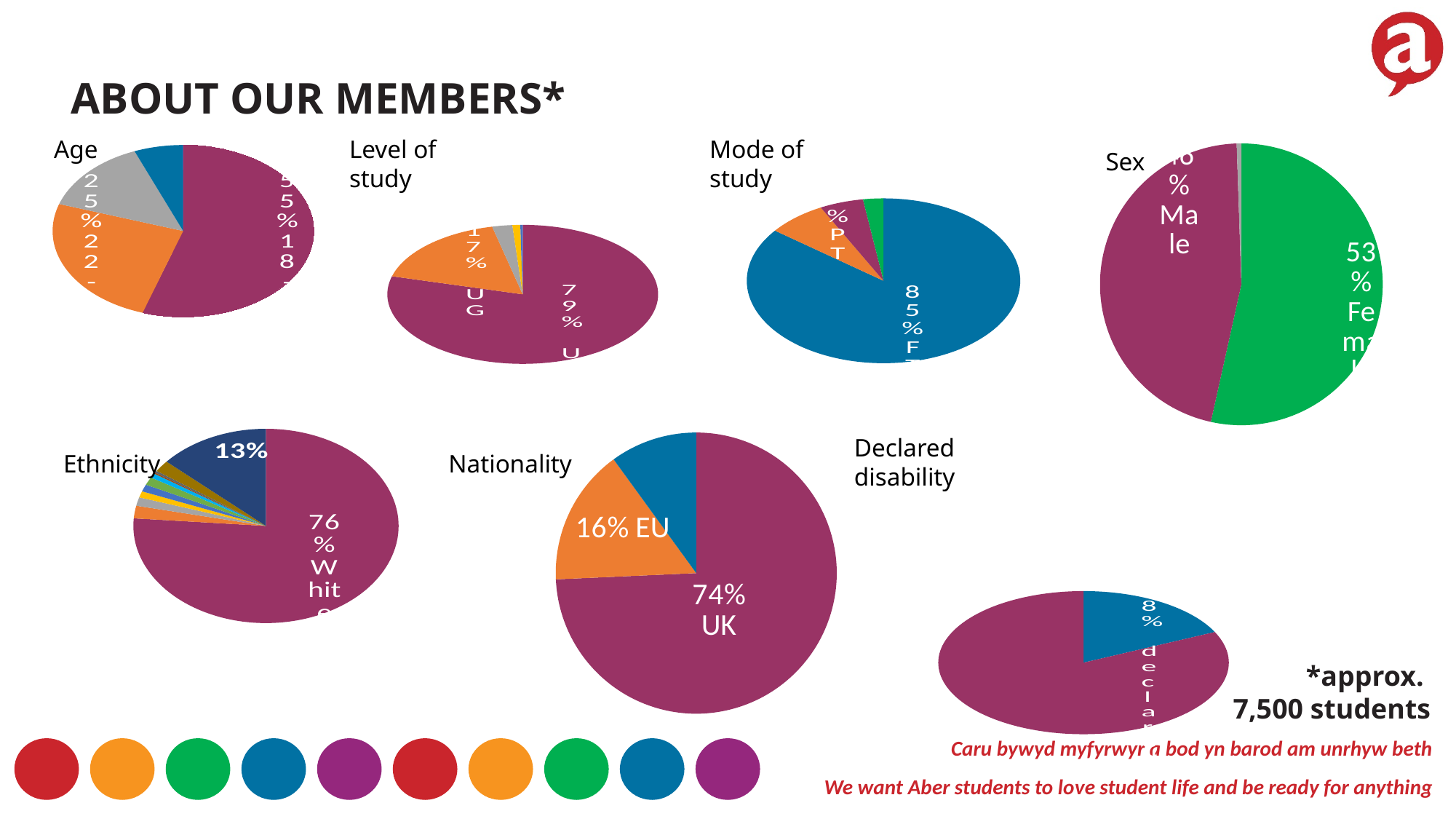
On the Sex chart, what percentage of members are female? 53% On the Nationality chart, how many slices does the pie have? 3 On the Mode of study chart, what is the percentage shown for the largest slice? 85% How many pie charts are shown on the slide? 7 What kind of chart is used for the Age breakdown? Pie chart On the Nationality chart, what percentage of members are from the UK? 74% On the Sex chart, which is larger, the Female slice or the Male slice? Female On the Declared disability chart, how many slices does the pie have? 2 On the Ethnicity chart, what percentage of members are White? 76% On the Nationality chart, what is the difference in percentage points between the UK and EU slices? 58 On the Nationality chart, what percentage of members are from the EU? 16%